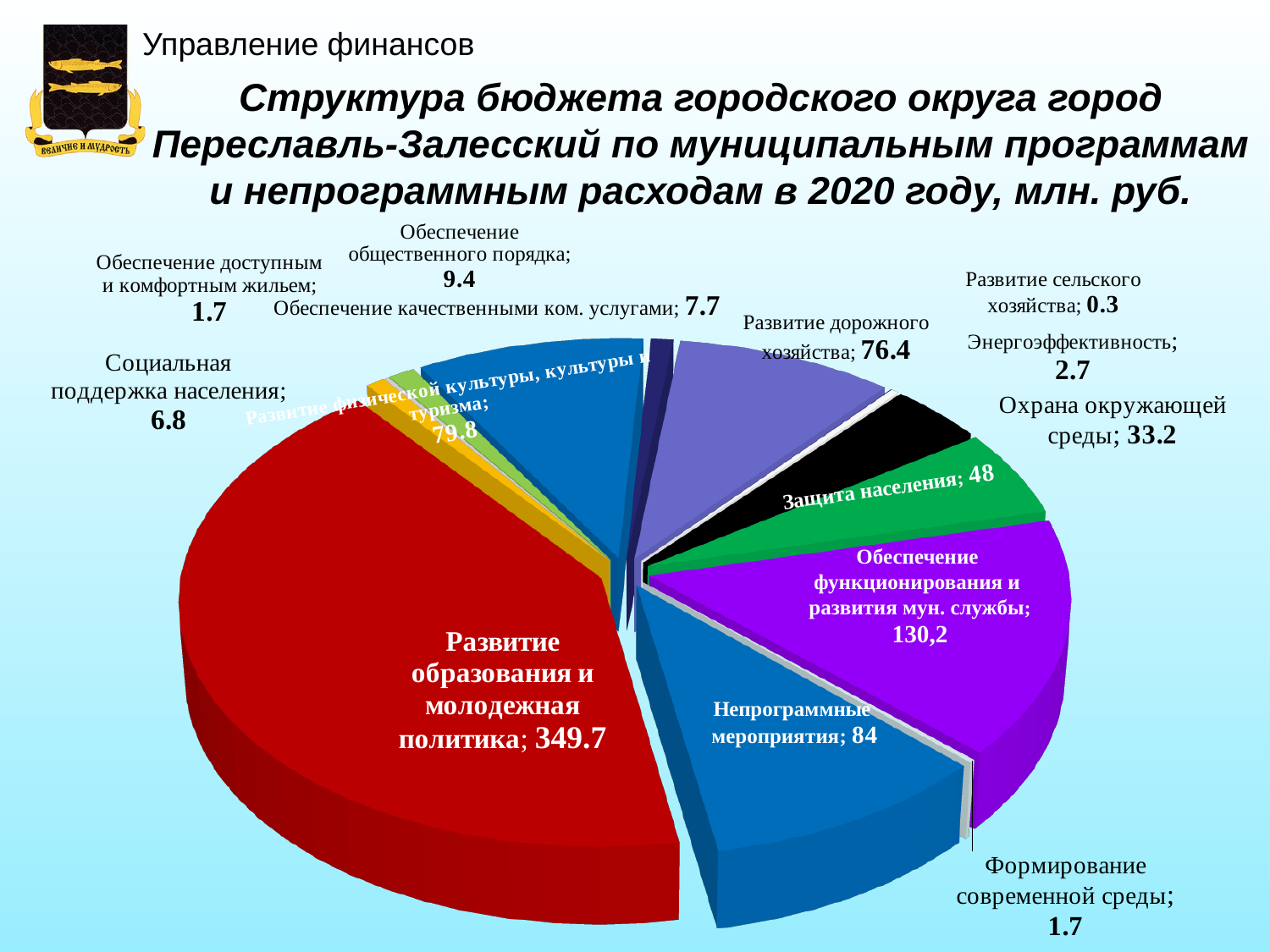
What is the difference between Развитие образования и молодежная политика and Обеспечение функционирования и развития мун. службы? 219.5 Which category has the smallest value? Развитие сельского хозяйства What is the value for Развитие дорожного хозяйства? 76.4 Which category has the largest value? Развитие образования и молодежная политика What kind of chart is shown on the slide? Pie chart Which is larger: Развитие физической культуры, культуры и туризма or Развитие дорожного хозяйства? Развитие физической культуры, культуры и туризма What is the value for Охрана окружающей среды? 33.2 How many categories are shown in the pie chart? 14 What is the difference between Непрограммные мероприятия and Защита населения? 36 What is the value for Непрограммные мероприятия? 84 What is the value for Обеспечение функционирования и развития мун. службы? 130,2 What is the value for Развитие образования и молодежная политика? 349.7